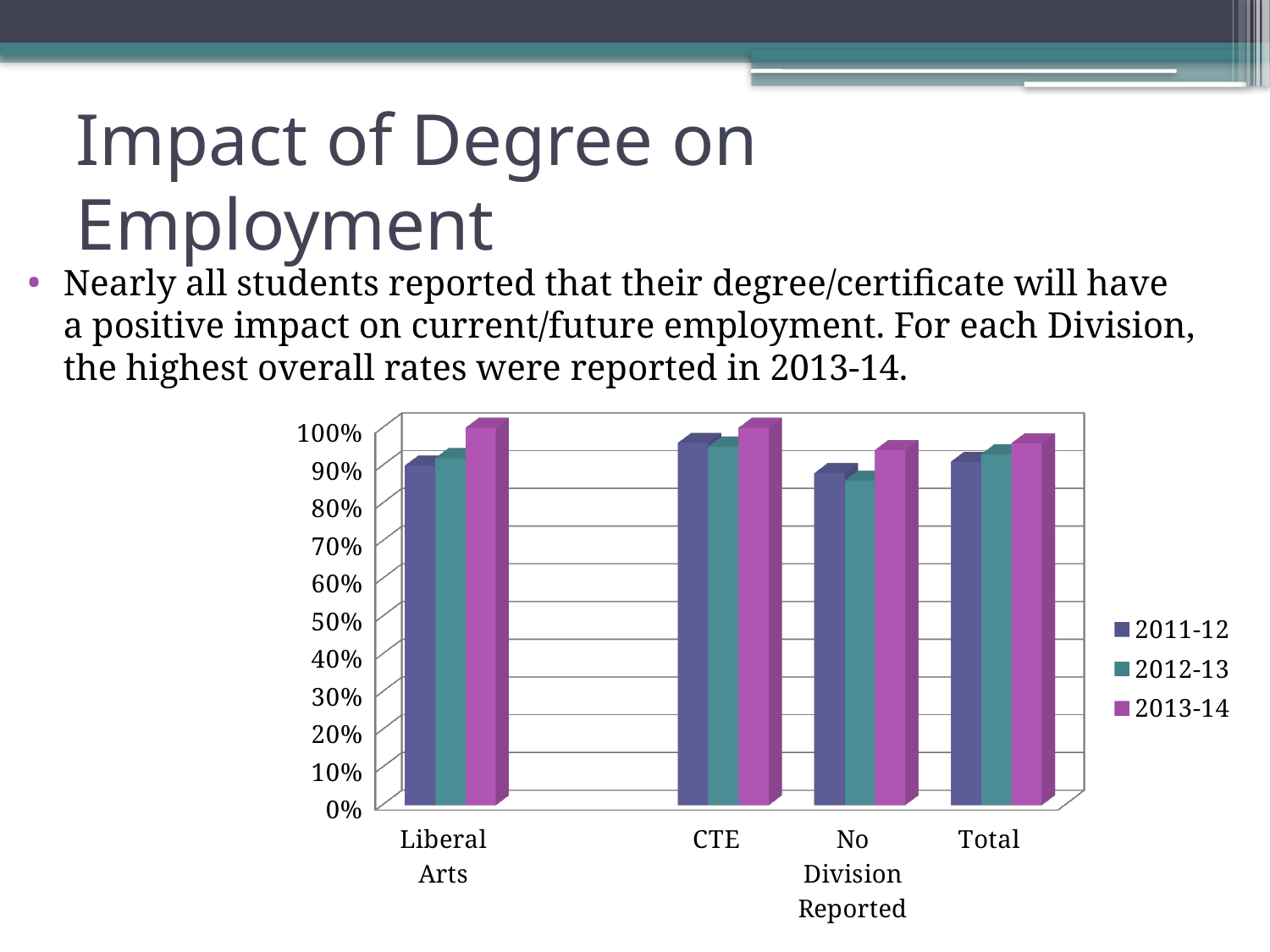
Which category has the lowest 2012-13 value? No Division Reported Which series are listed in the chart's legend? 2011-12, 2012-13, 2013-14 For No Division Reported, which is larger: the 2012-13 value or the 2013-14 value? 2013-14 Is the 2012-13 value for No Division Reported greater or less than 90%? less How many categories are shown on the x axis of the chart? 4 How many series does the chart's legend list? 3 What kind of chart is shown on the slide? bar chart Is the 2011-12 value for CTE greater or less than 90%? greater For Liberal Arts, which series has the highest value? 2013-14 Is the 2011-12 value for Liberal Arts greater or less than 80%? greater For Liberal Arts, which is larger: the 2011-12 value or the 2013-14 value? 2013-14